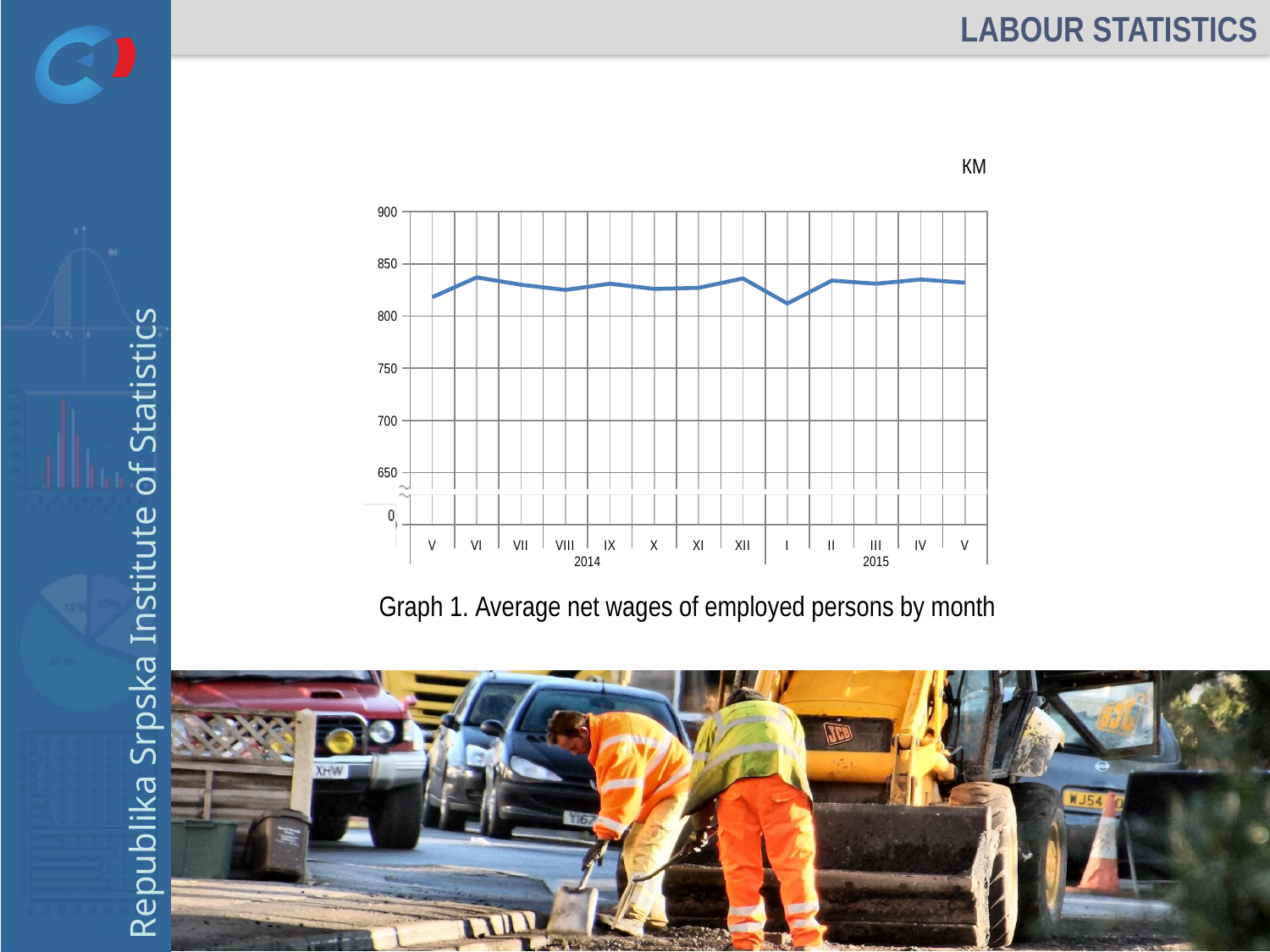
Does the line rise or fall from V 2014 to VI 2014? rise Is the value for I 2015 greater or less than 800? greater Does the line rise or fall from XII 2014 to I 2015? fall Is the value for VI 2014 greater or less than 850? less How many monthly data points are plotted on the chart? 13 Is the value for V 2014 greater or less than 800? greater What is the title of the chart? Graph 1. Average net wages of employed persons by month Which month has the lowest average net wage on the chart? I 2015 What kind of chart is shown on the slide? line chart Which is higher, the value for I 2015 or the value for II 2015? II 2015 Which is higher, the value for V 2014 or the value for VI 2014? VI 2014 What unit is indicated for the values on the chart? KM